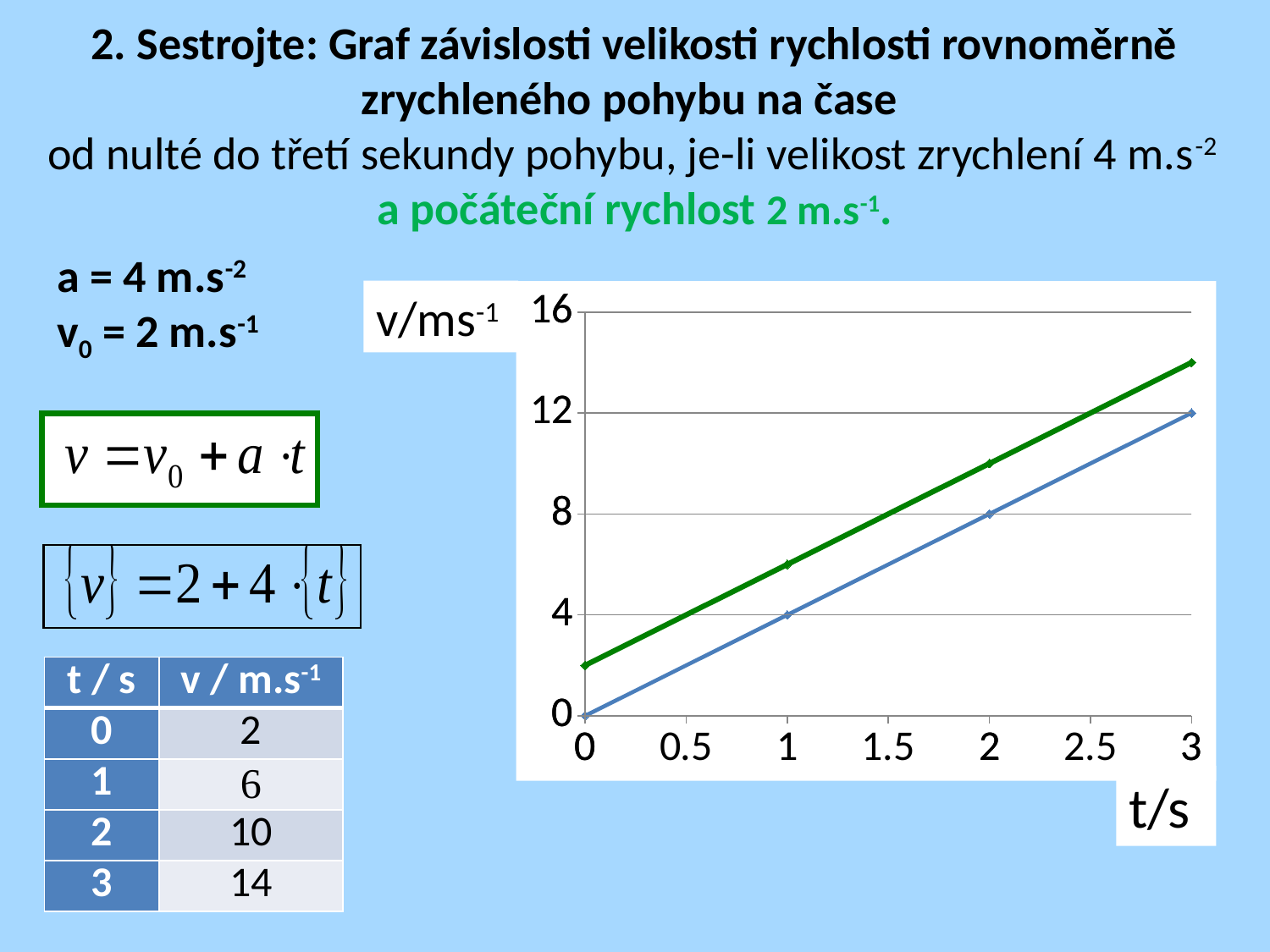
What is the value of the green line at t = 3 s? 14 Do the values of the green line rise or fall as t increases? rise What kind of chart is shown on the slide? line chart What is the difference between the green line and the blue line at t = 3 s? 2 What is the label of the vertical axis of the chart? v/ms-1 How many lines are plotted on the chart? 2 What is the value of the green line at t = 0 s? 2 What is the value of the blue line at t = 1 s? 4 Is the value of the green line at t = 2 s greater or less than 8? greater At t = 3 s, which line has the higher value, the green line or the blue line? green line What is the value of the blue line at t = 3 s? 12 What is the value of the blue line at t = 2 s? 8